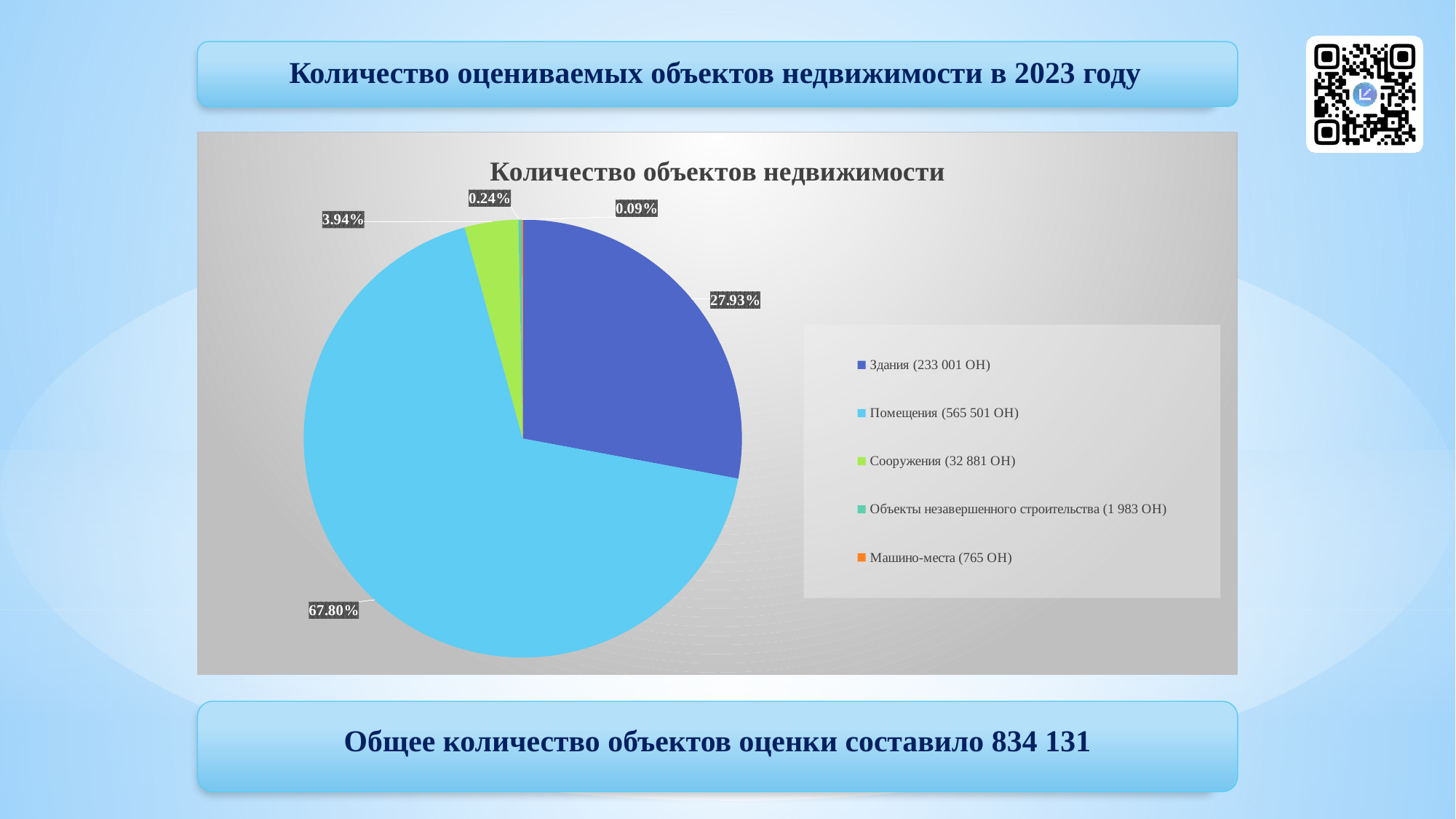
What share of the pie does Сооружения take? 3.94% What share of the pie does Здания take? 27.93% How many objects (ОН) are listed in the legend for Объекты незавершенного строительства? 1 983 ОН Which is larger, the share for Здания or the share for Сооружения? Здания What share of the pie does Машино-места take? 0.09% Which category has the smallest slice of the pie? Машино-места What is the title of the chart? Количество объектов недвижимости How many slices does the pie chart have? 5 Which category has the largest slice of the pie? Помещения What kind of chart is shown on the slide? pie chart How many objects (ОН) are listed in the legend for Здания? 233 001 ОН